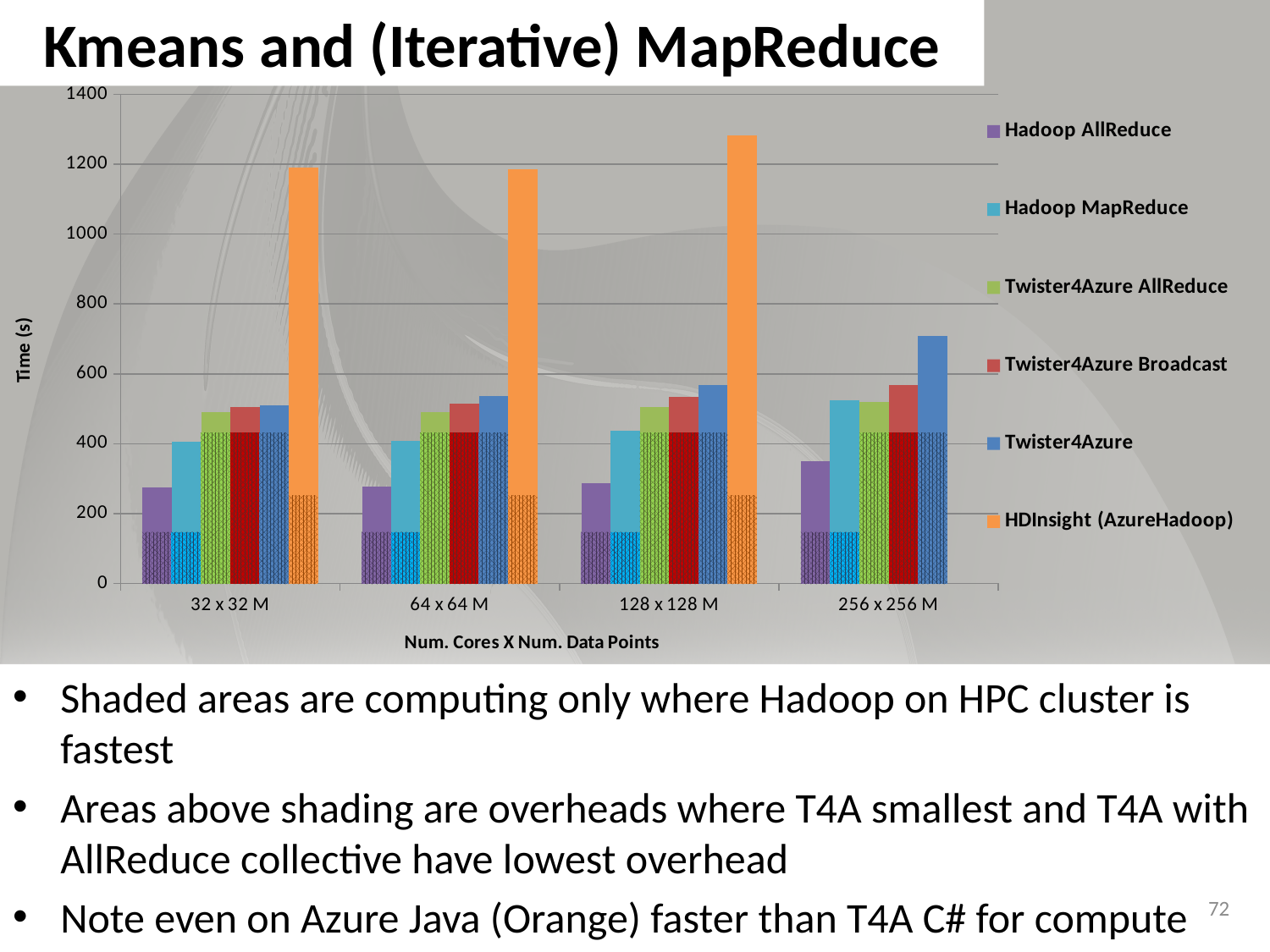
What is the title of the x axis? Num. Cores X Num. Data Points Is the value for Hadoop AllReduce at 32 x 32 M greater or less than 400? less How many categories are shown on the x axis of the chart? 4 Is the value for Twister4Azure at 256 x 256 M greater or less than 600? greater Which series has the lowest value for 128 x 128 M? Hadoop AllReduce How many series does the chart's legend list? 6 Is the value for HDInsight (AzureHadoop) at 128 x 128 M greater or less than 1200? greater Do the Twister4Azure values rise or fall as the categories go from 32 x 32 M to 256 x 256 M? rise What is the title of the y axis? Time (s) What kind of chart is shown on the slide? bar chart Which series has the highest value for 32 x 32 M? HDInsight (AzureHadoop) At 256 x 256 M, which is larger: Hadoop MapReduce or Hadoop AllReduce? Hadoop MapReduce